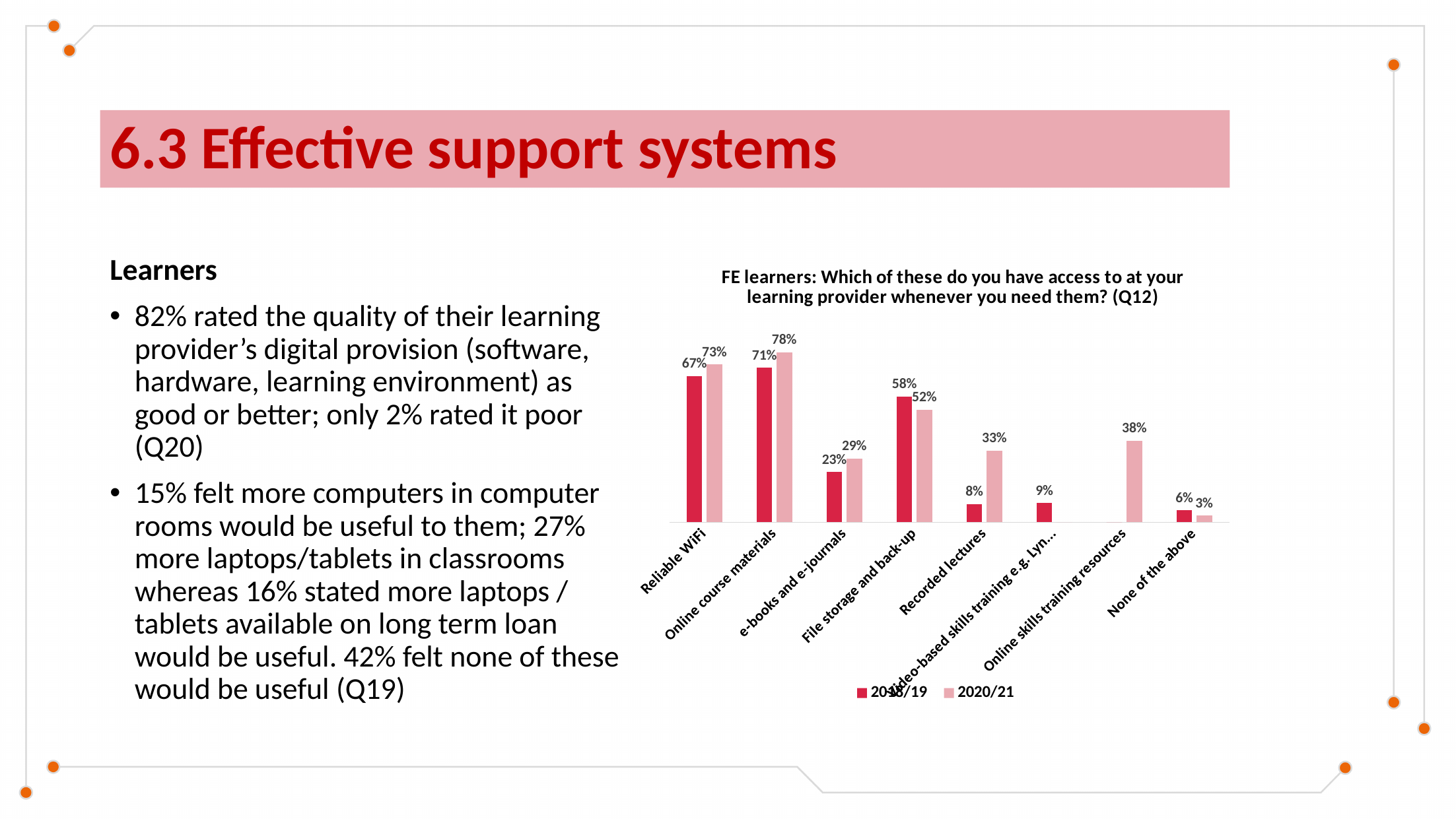
What is the 2020/21 value for Reliable WiFi? 73% What is the 2020/21 value for Online skills training resources? 38% How many categories are shown on the x axis of the chart? 8 What is the 2020/21 value for Online course materials? 78% What is the title of the chart? FE learners: Which of these do you have access to at your learning provider whenever you need them? (Q12) What is the 2020/21 value for Recorded lectures? 33% What kind of chart is shown on the slide? bar chart What is the difference between the 2020/21 values for Online course materials and Reliable WiFi? 5% Which category has the highest 2020/21 value? Online course materials Which is larger for File storage and back-up: the 2018/19 value or the 2020/21 value? 2018/19 How many series does the chart legend list? 2